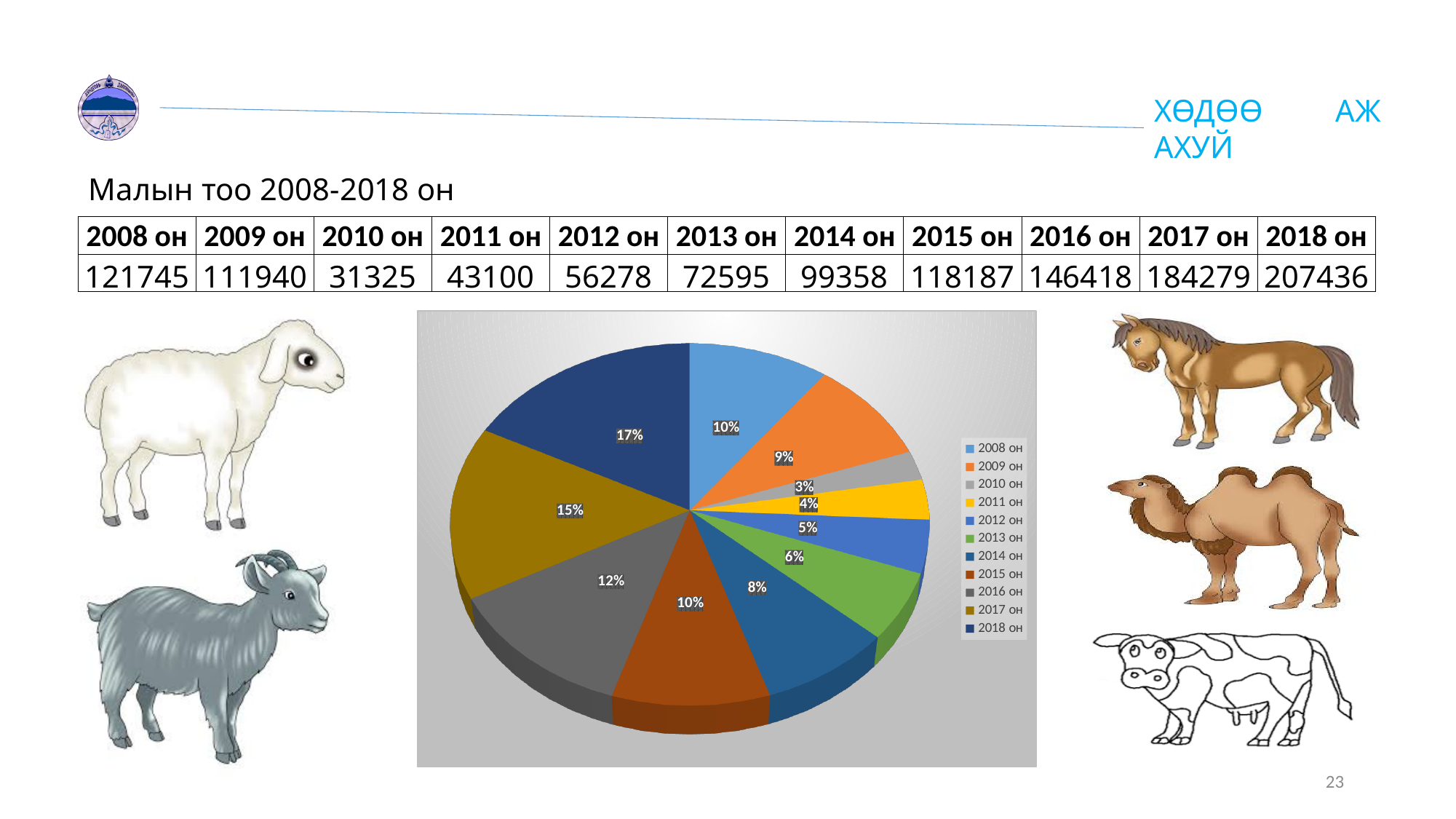
What percentage is shown for the 2013 он slice? 6% What share of the pie does the 2018 он slice represent? 17% What percentage is shown for the 2016 он slice? 12% Which year has the smallest slice of the pie? 2010 он Which slice is larger, 2017 он or 2014 он? 2017 он What share of the pie does the 2010 он slice represent? 3% What colour is the 2009 он slice in the pie chart? orange Which year has the largest slice of the pie? 2018 он How many percentage points larger is the 2018 он slice than the 2010 он slice? 14 How many entries does the legend list? 11 How many slices does the pie chart have? 11 What kind of chart is shown on the slide? pie chart